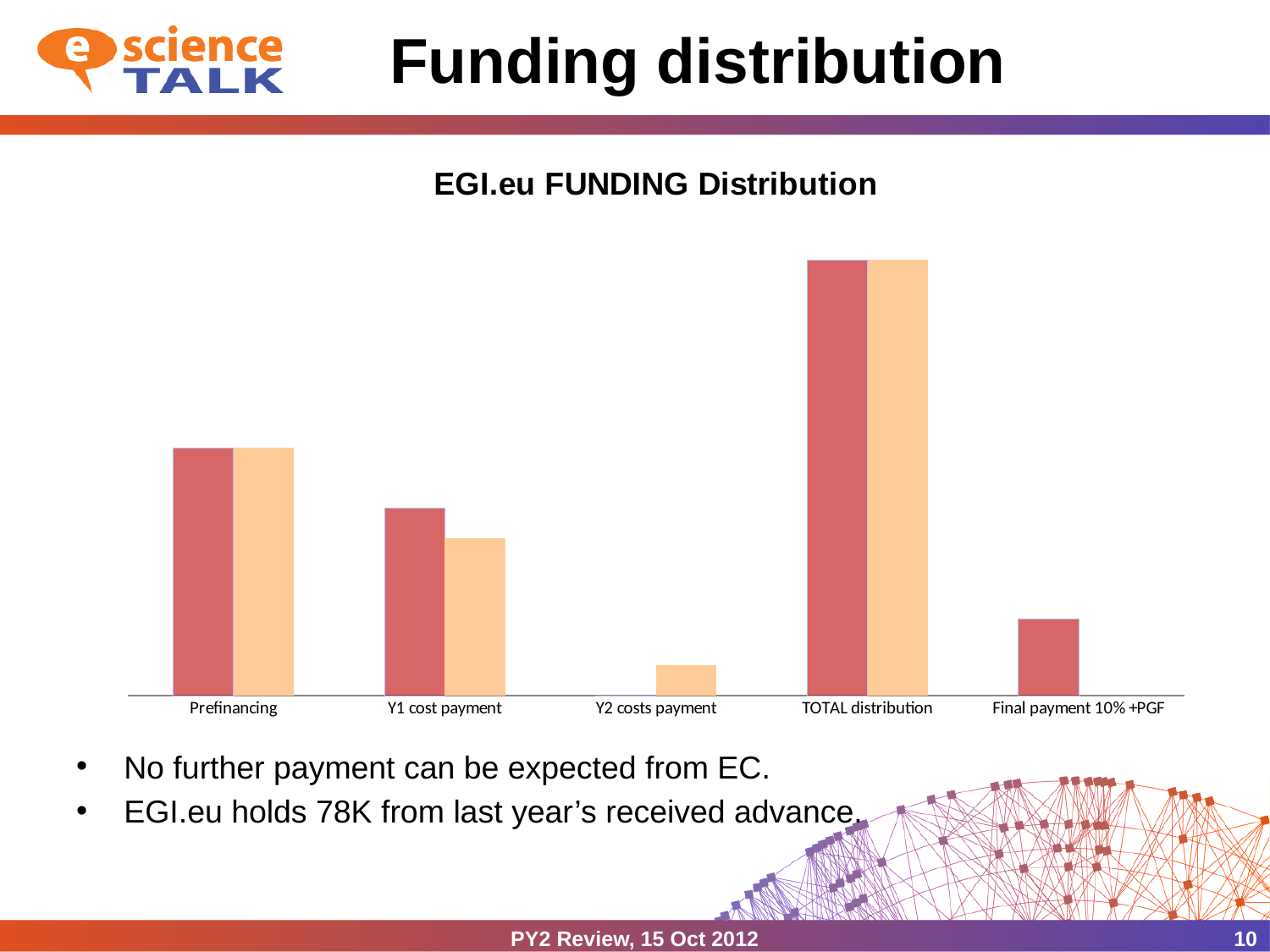
For Y1 cost payment, which bar is taller, the red one or the orange one? the red one Which category has the lowest red bar in the chart? Y2 costs payment How many categories are shown on the x axis of the chart? 5 Is the red bar for Final payment 10% +PGF taller or shorter than the red bar for Y1 cost payment? shorter For Y2 costs payment, which bar is taller, the red one or the orange one? the orange one What kind of chart is shown on the slide? bar chart Which category is the last one on the x axis of the chart? Final payment 10% +PGF Which category has the tallest bars in the chart? TOTAL distribution How many different bar colours are used in the chart? 2 What is the title of the chart? EGI.eu FUNDING Distribution